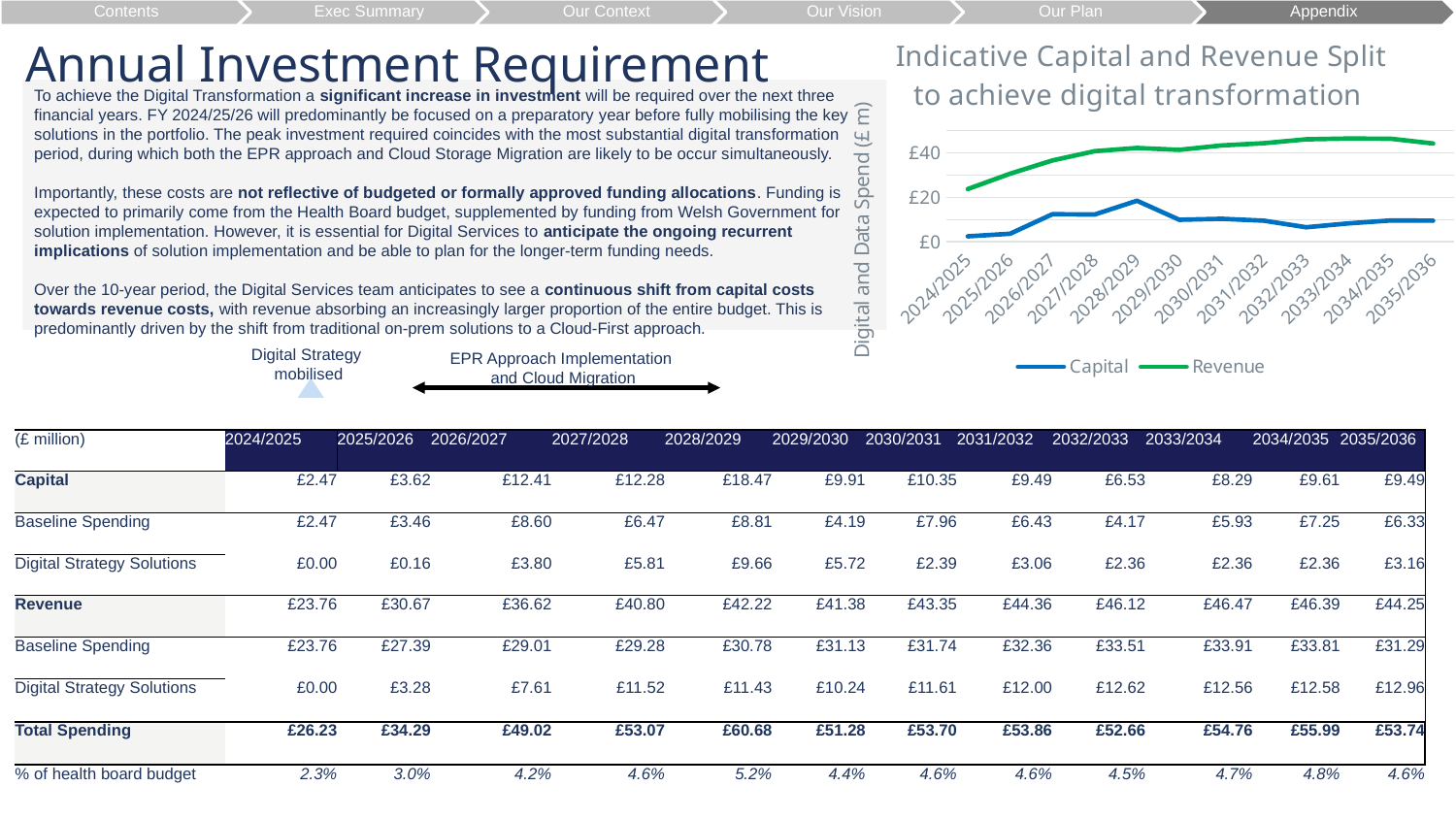
How many series does the chart legend list? 2 Which colour is used for the Revenue line in the chart? green What kind of chart is shown on the slide? line chart Is the Revenue value for 2024/2025 greater or less than £20? greater Is the Revenue value for 2035/2036 greater or less than £40? greater What is the label on the chart's vertical axis? Digital and Data Spend (£ m) Is the Capital value for 2024/2025 greater or less than £20? less How many financial years are plotted along the x axis of the chart? 12 Which series has the larger value in 2030/2031, Capital or Revenue? Revenue In which financial year does the Capital line reach its highest point? 2028/2029 Does the Revenue line rise or fall between 2024/2025 and 2028/2029? rise In which financial year is the Revenue line at its lowest? 2024/2025